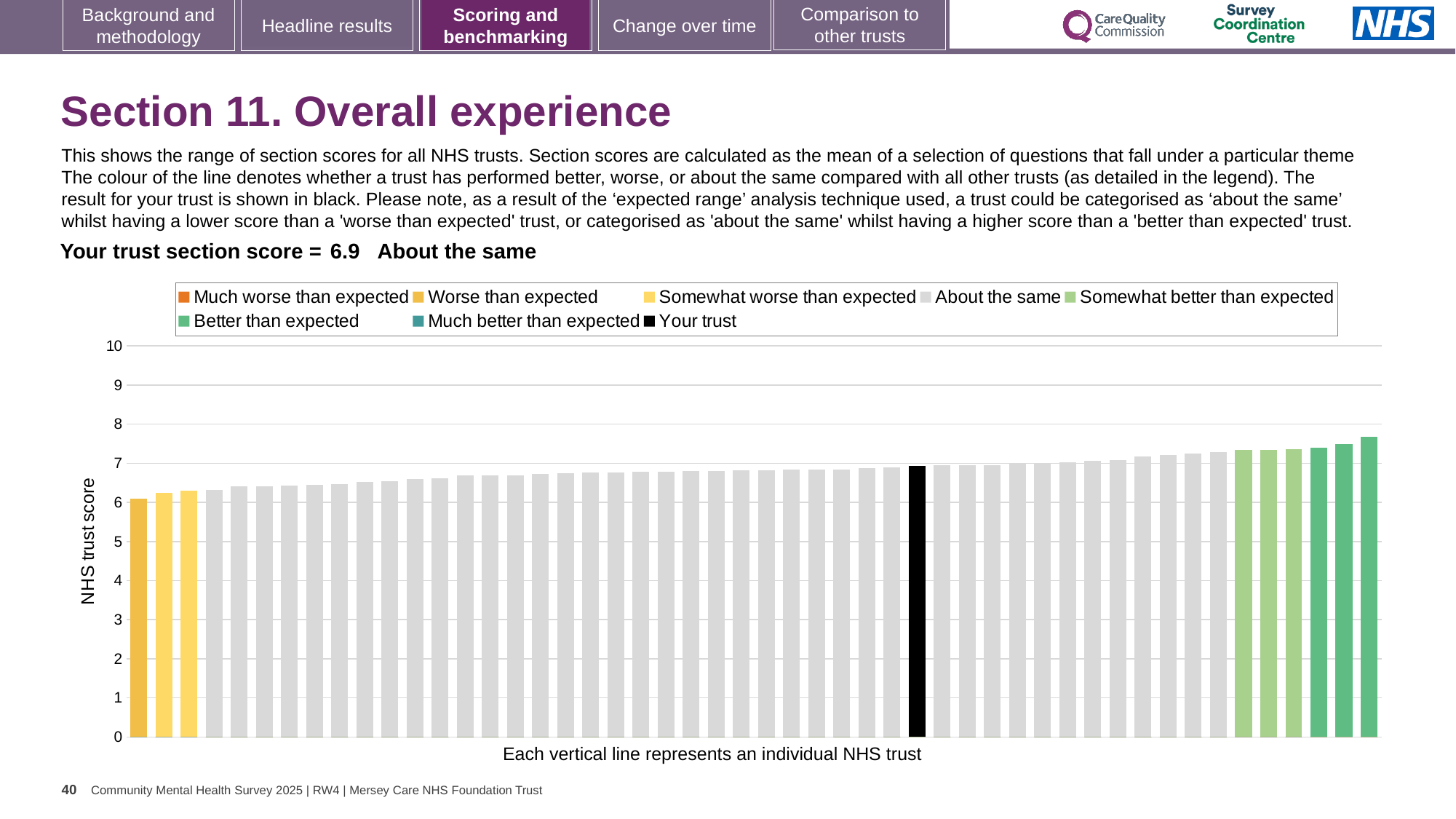
How many entries does the chart legend list? 8 Is the value of the shortest bar greater or less than 7? less What is the label on the vertical axis of the chart? NHS trust score Do the bar values rise or fall from left to right along the x axis? Rise Is the value for your trust (the black bar) greater or less than 5? greater What colour is used for the bar representing your trust? Black Is the value of the tallest bar greater or less than 7? greater What is the section score for your trust shown on the slide? 6.9 What kind of chart is shown on the slide? Bar chart Which category is your trust placed in for this section? About the same